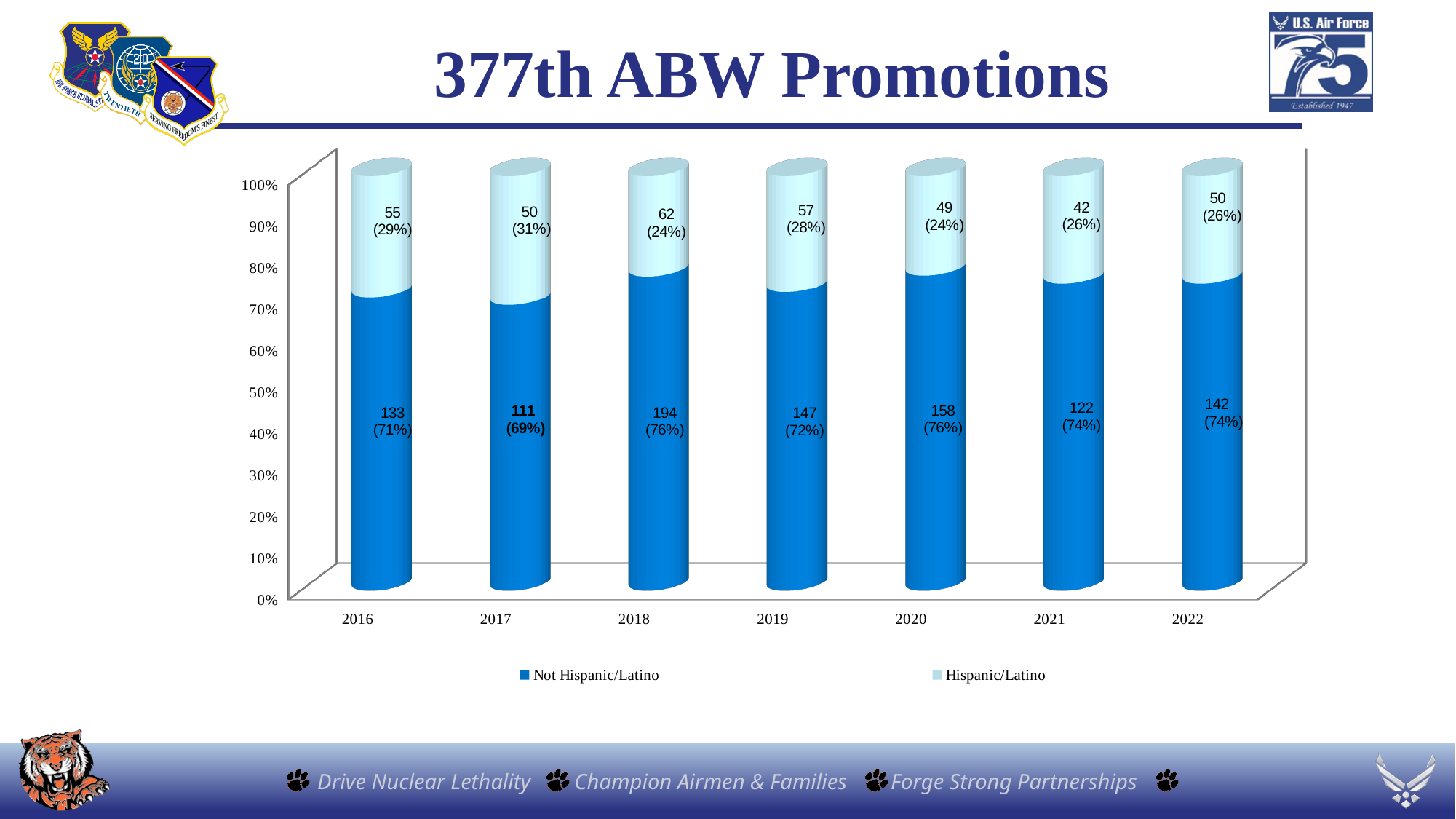
Which is larger, the number of Hispanic/Latino promotions in 2016 or in 2020? 2016 Which year has the lowest number of Hispanic/Latino promotions? 2021 What is the total number of promotions in 2016? 188 What is the title of the chart? 377th ABW Promotions How many series does the legend list? 2 How many years are shown on the x axis? 7 What is the difference between Not Hispanic/Latino and Hispanic/Latino promotions in 2018? 132 What kind of chart is shown on the slide? Stacked bar chart What percentage of promotions in 2017 were Hispanic/Latino? 31% What is the number of Not Hispanic/Latino promotions in 2018? 194 What is the number of Hispanic/Latino promotions in 2021? 42 Which year has the highest number of Not Hispanic/Latino promotions? 2018